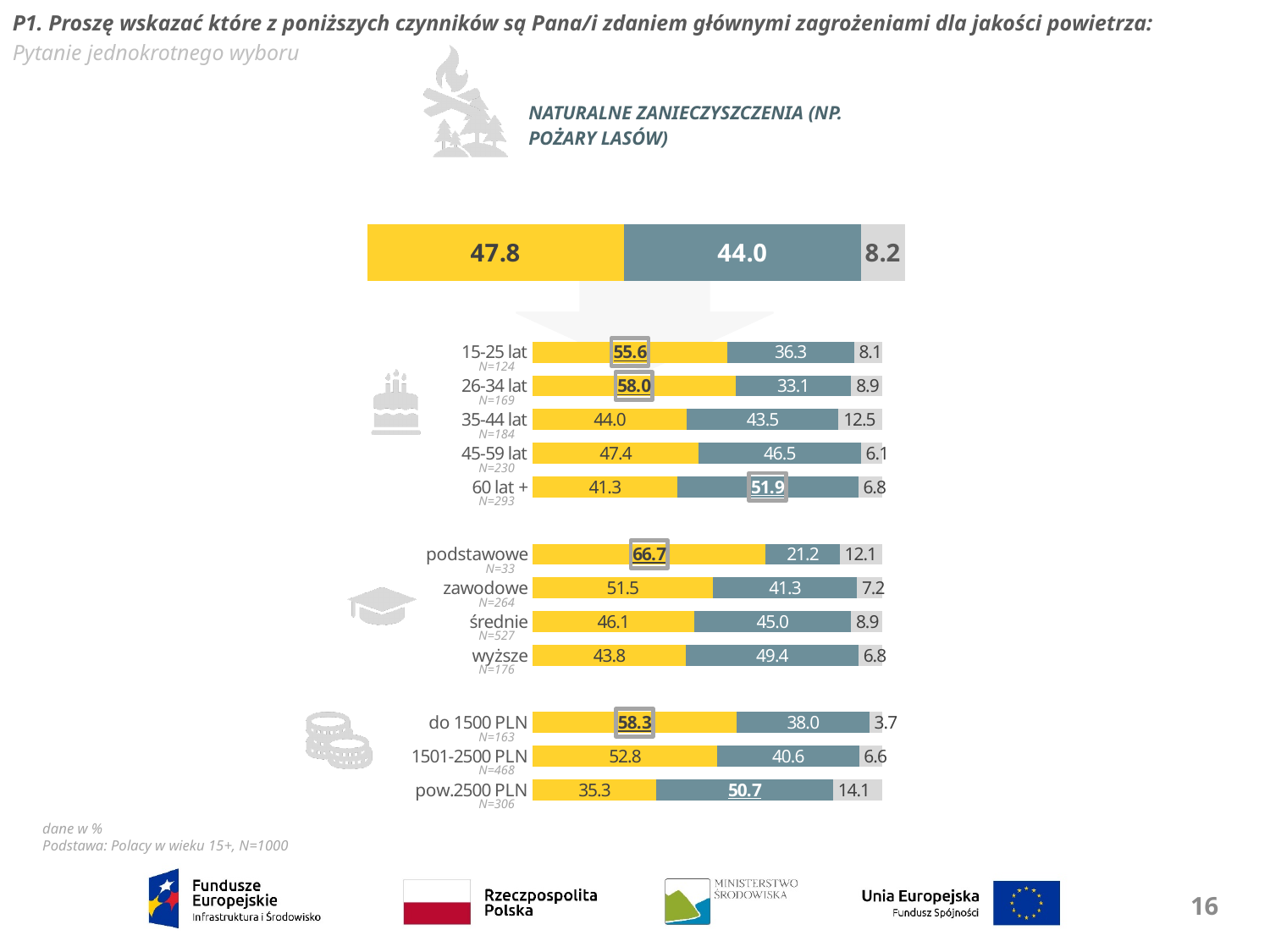
What is the value of the light grey segment in the overall (top) bar? 8.2 What is the total of the three segments in the 15-25 lat bar? 100.0 What is the value of the yellow segment for the 26-34 lat age group? 58.0 Which has a larger yellow segment value: podstawowe or wyższe? podstawowe How many age group categories are shown in the chart? 5 How many education level categories are shown in the chart? 4 Among the age groups, which has the highest yellow segment value? 26-34 lat Among the income groups, which has the lowest yellow segment value? pow.2500 PLN In the overall (top) bar, what is the difference between the yellow value and the grey-blue value? 3.8 What is the value of the grey-blue segment for the 60 lat + age group? 51.9 What is the value of the light grey segment for the pow.2500 PLN income group? 14.1 What kind of chart is shown on the slide? Stacked bar chart